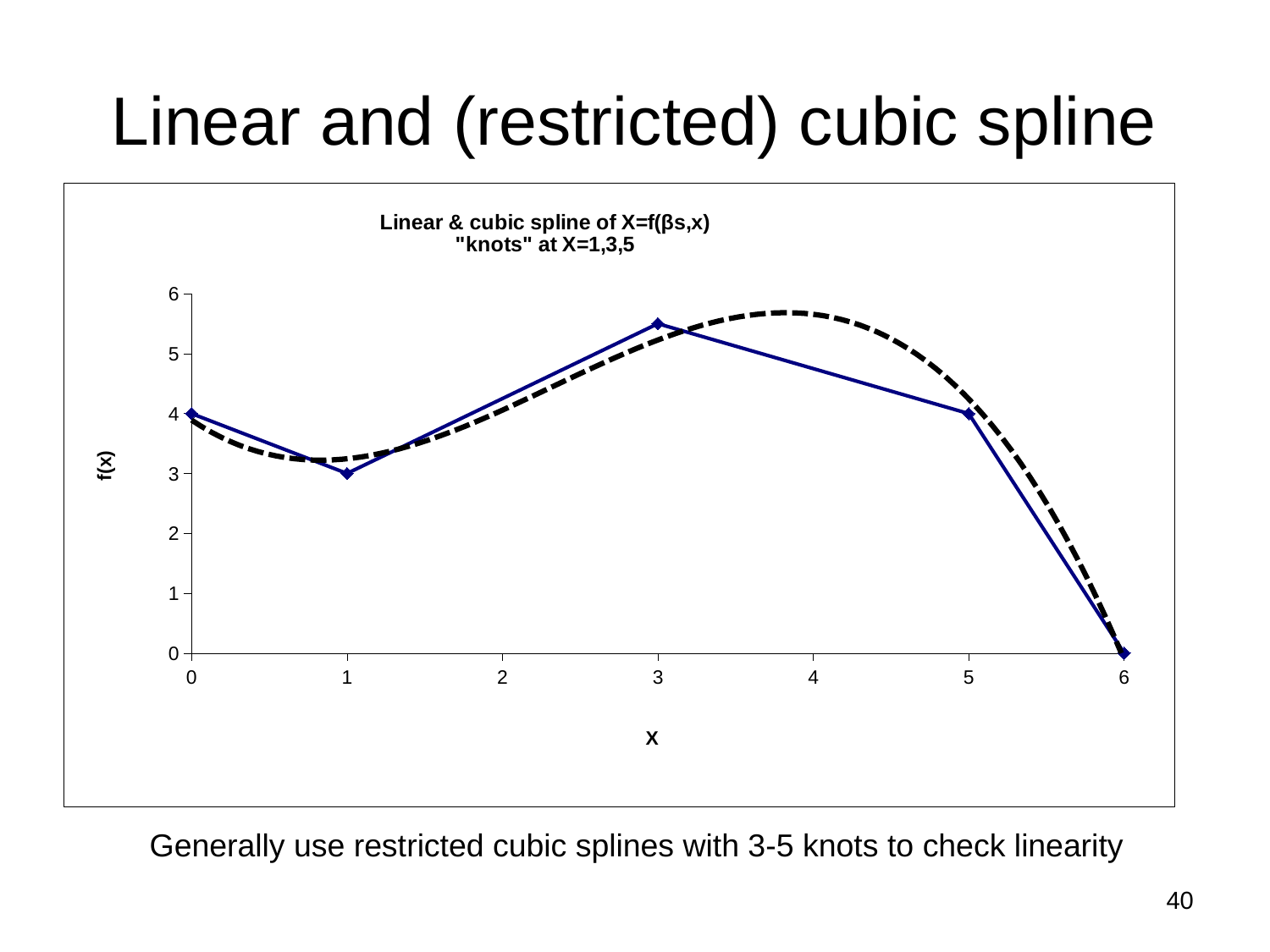
What is the value of the solid linear spline at x = 1? 3 What is the title of the chart? Linear & cubic spline of X=f(βs,x) "knots" at X=1,3,5 What is the label of the vertical axis? f(x) At which x value does the solid linear spline reach its highest point? 3 What is the value of the solid linear spline at x = 6? 0 Does the solid linear spline rise or fall between x = 3 and x = 6? fall Is the value of the solid linear spline at x = 3 greater or less than 5? greater What kind of chart is shown on the slide? line chart At which x value does the solid linear spline reach its lowest point? 6 How many marked data points does the solid linear spline have? 5 What is the value of the solid linear spline at x = 5? 4 What is the value of the solid linear spline at x = 0? 4